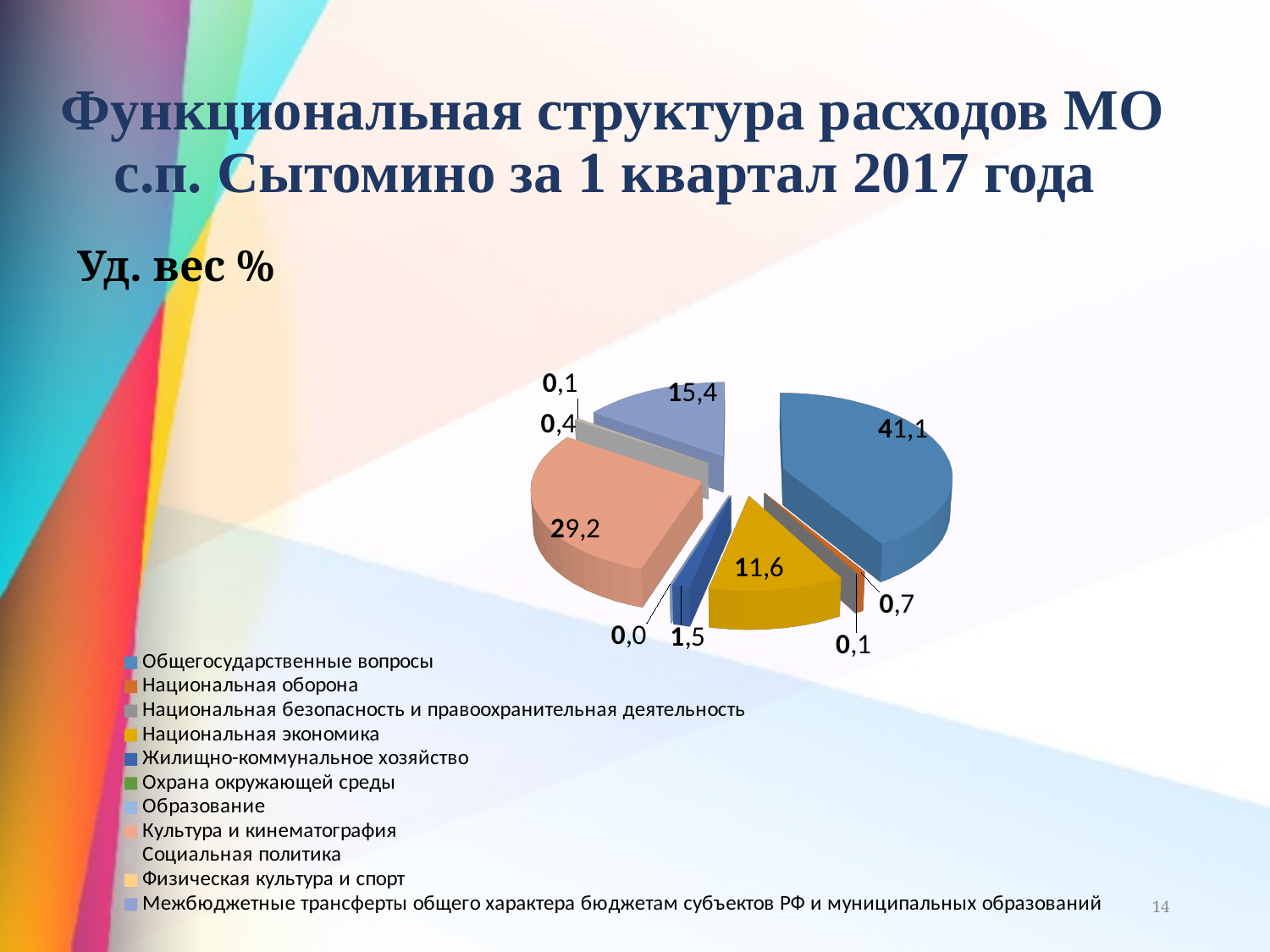
Which category has the largest share of the pie? Общегосударственные вопросы Which is larger, the value for Национальная экономика or the value for Межбюджетные трансферты? Межбюджетные трансферты What is the value shown for Национальная оборона? 0,7 What unit is indicated for the chart values on the slide? Уд. вес % What is the value shown for Национальная экономика? 11,6 What is the difference between the values for Общегосударственные вопросы and Культура и кинематография? 11,9 How many categories does the legend list? 11 What kind of chart is shown on the slide? pie chart What is the value shown for Культура и кинематография? 29,2 What is the value shown for Общегосударственные вопросы? 41,1 What is the value shown for Межбюджетные трансферты общего характера бюджетам субъектов РФ и муниципальных образований? 15,4 What is the value shown for Жилищно-коммунальное хозяйство? 1,5